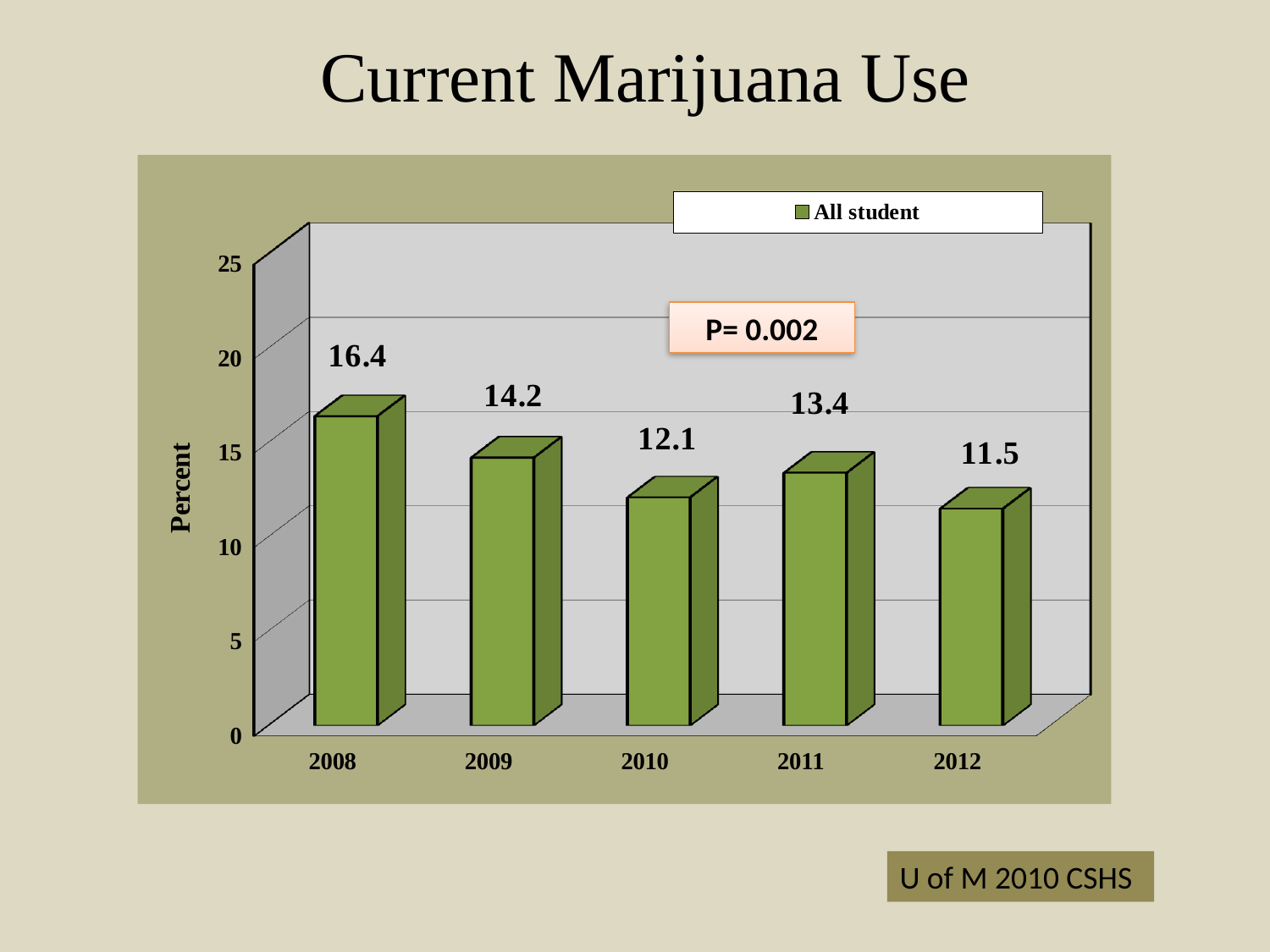
What is the value for 2008? 16.4 What kind of chart is shown on the slide? bar chart What is the value for 2012? 11.5 How many years are shown on the x axis? 5 Which year has the highest value? 2008 What is the value for 2010? 12.1 What is the difference between the values for 2008 and 2012? 4.9 Is the value for 2008 greater or less than 15? greater What is the difference between the values for 2011 and 2010? 1.3 Which year has the lowest value? 2012 Which is larger, the value for 2009 or the value for 2011? 2009 What is the title of the chart? Current Marijuana Use